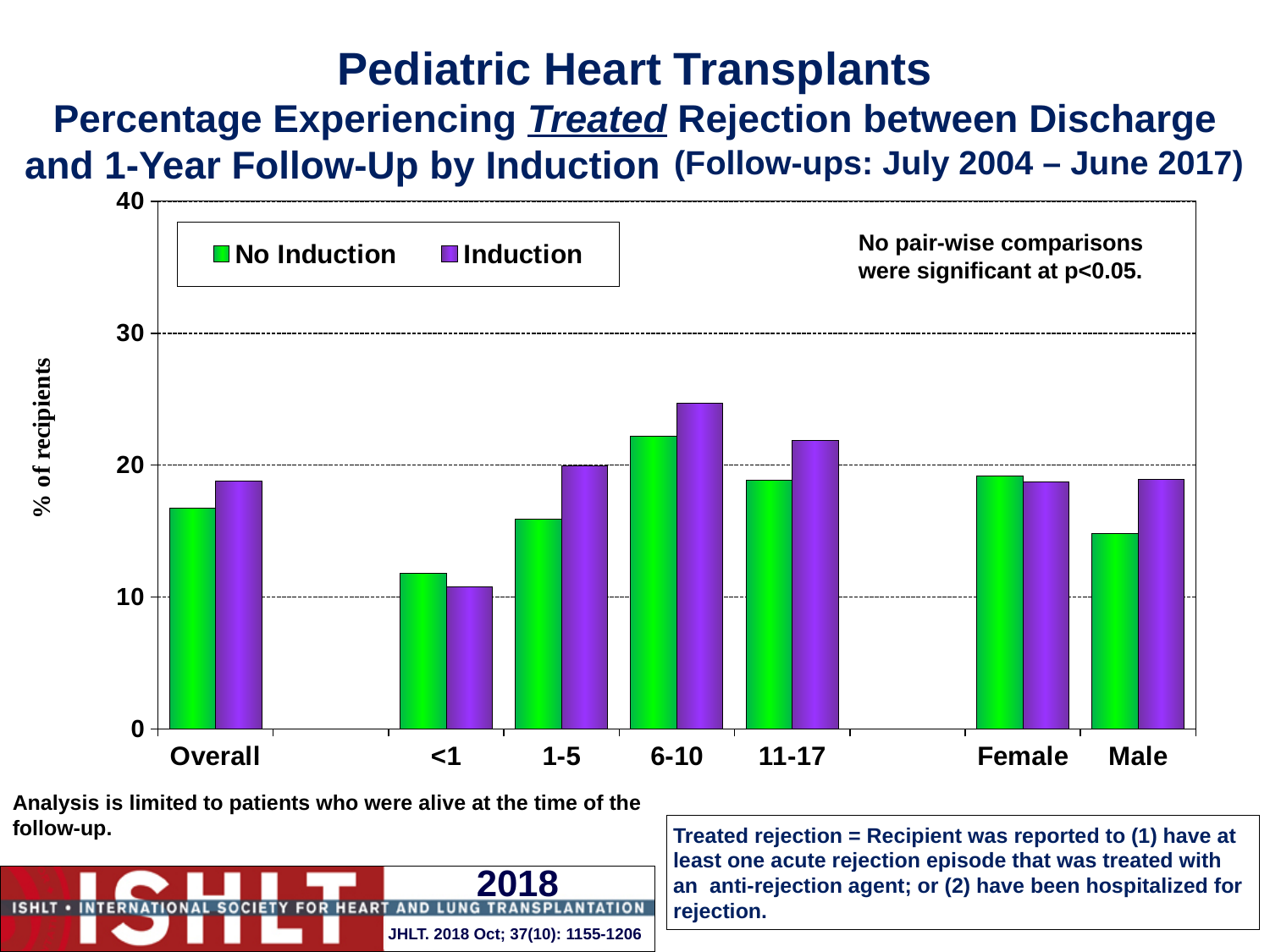
Which category has the lowest value for the No Induction series? <1 How many series does the legend list? 2 In the <1 category, which is larger: No Induction or Induction? No Induction What is the label of the y axis? % of recipients Is the value for No Induction in the Male category greater or less than 20? less How many categories are shown along the x axis? 7 Is the value for Induction in the 6-10 category greater or less than 20? greater In the Male category, which is larger: No Induction or Induction? Induction Which category has the lowest value for the Induction series? <1 Which category has the highest value for the Induction series? 6-10 Is the value for No Induction in the <1 category greater or less than 10? greater What kind of chart is shown on the slide? bar chart